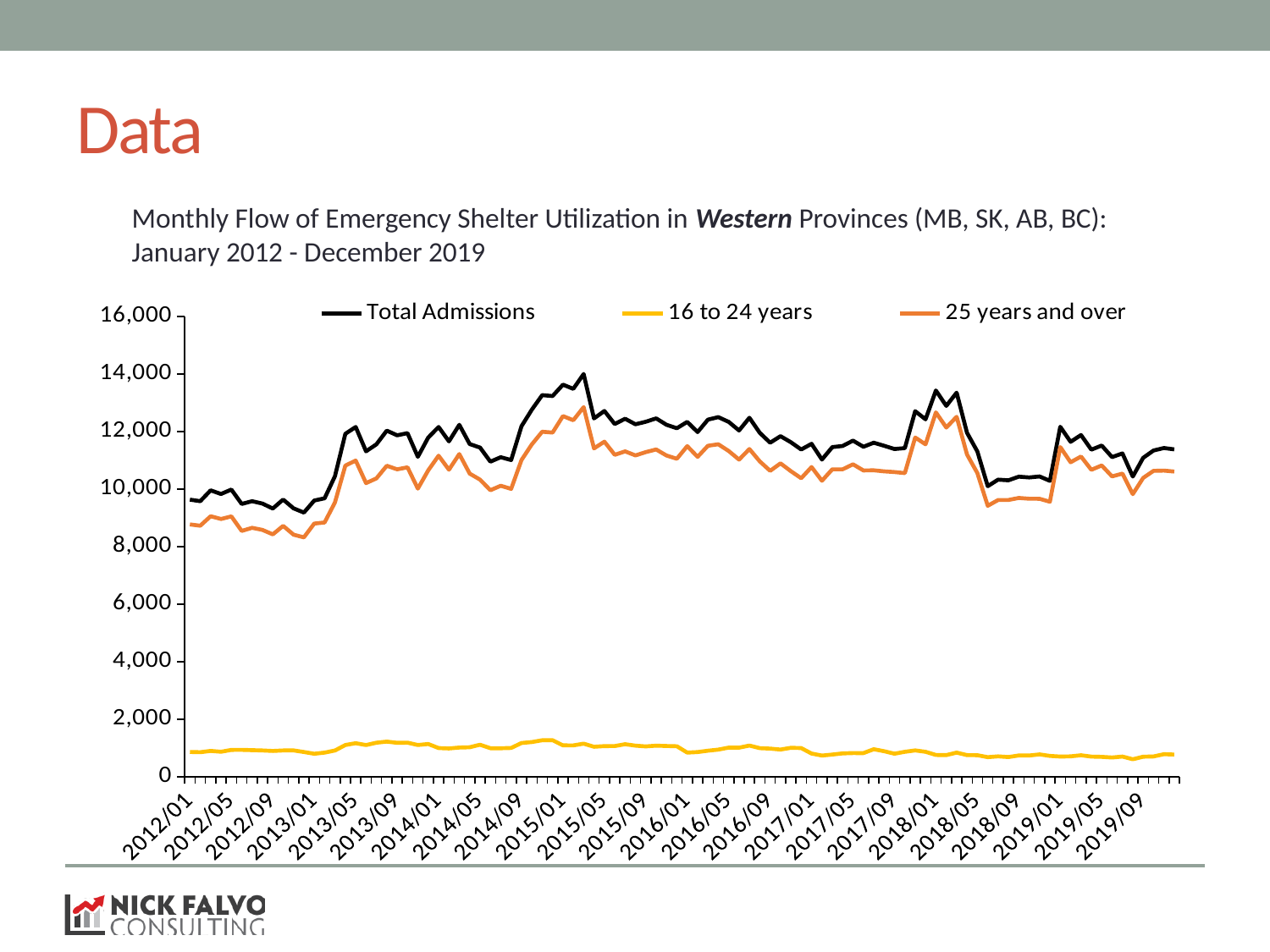
Which series is plotted with the black line? Total Admissions Is the value for 25 years and over at 2012/09 greater or less than 10,000? less At 2016/01, which is larger: 25 years and over or 16 to 24 years? 25 years and over How many series does the legend list? 3 Is the value for 16 to 24 years at 2015/01 greater or less than 2,000? less Does the Total Admissions line rise or fall between 2012/09 and 2013/05? Rise What kind of chart is shown on the slide? Line chart Is the value for Total Admissions at 2012/01 greater or less than 10,000? less What is the highest value shown on the vertical axis? 16,000 Which series has the lowest values throughout the chart? 16 to 24 years Which series has the highest values throughout the chart? Total Admissions